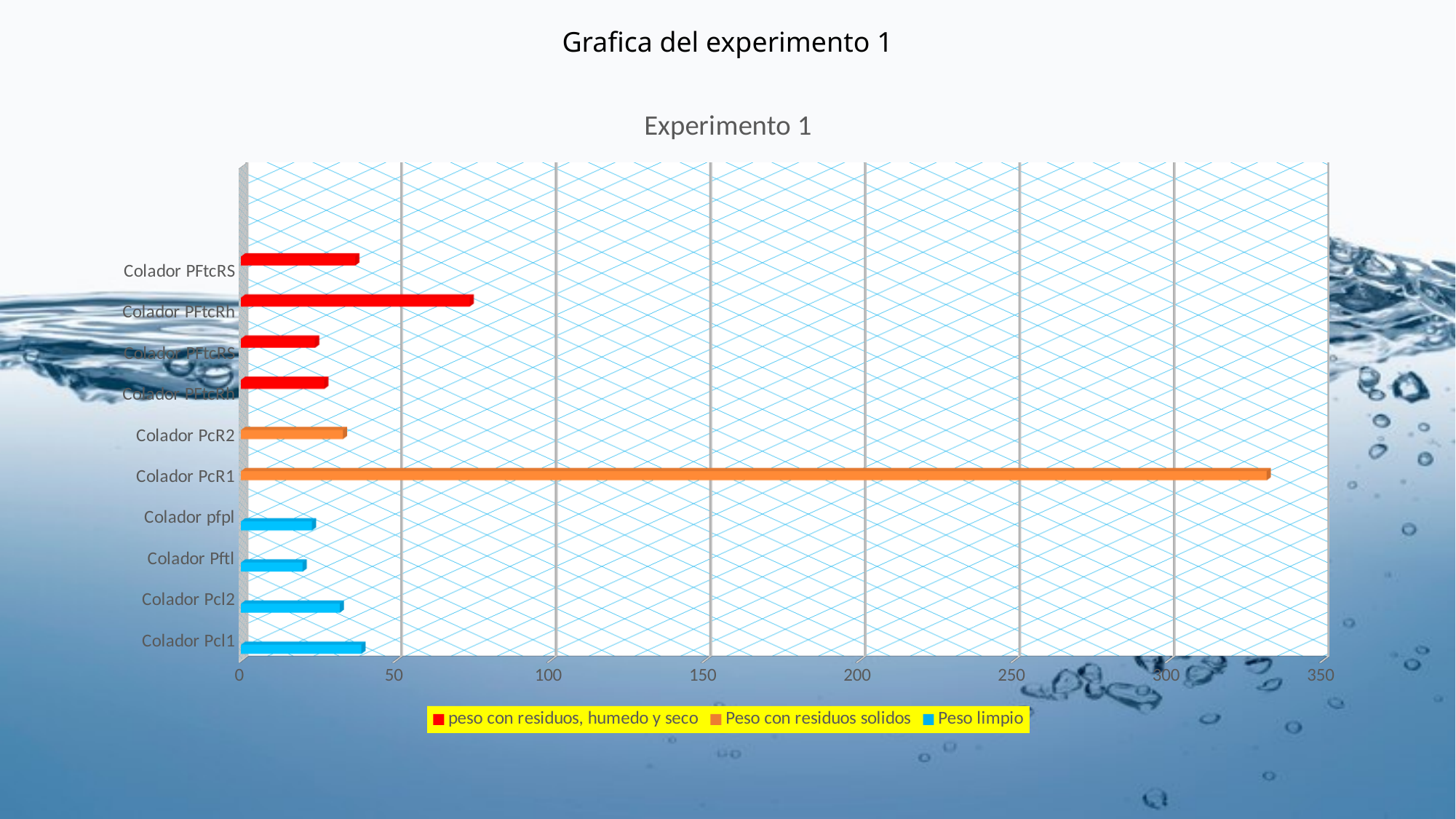
How many categories are plotted on the chart? 10 Is the value for Colador Pcl1 greater or less than 50? less Which category has the highest value? Colador PcR1 Is the value for Colador PcR1 greater or less than 300? greater Is the value for Colador PcR1 greater or less than 350? less What kind of chart is shown on the slide? bar chart How many series does the legend list? 3 What is the title of the chart? Experimento 1 Which colour represents the series 'Peso limpio' in the legend? blue Which is larger, the value for Colador PcR1 or Colador PcR2? Colador PcR1 Which is larger, the value for Colador Pcl1 or Colador Pftl? Colador Pcl1